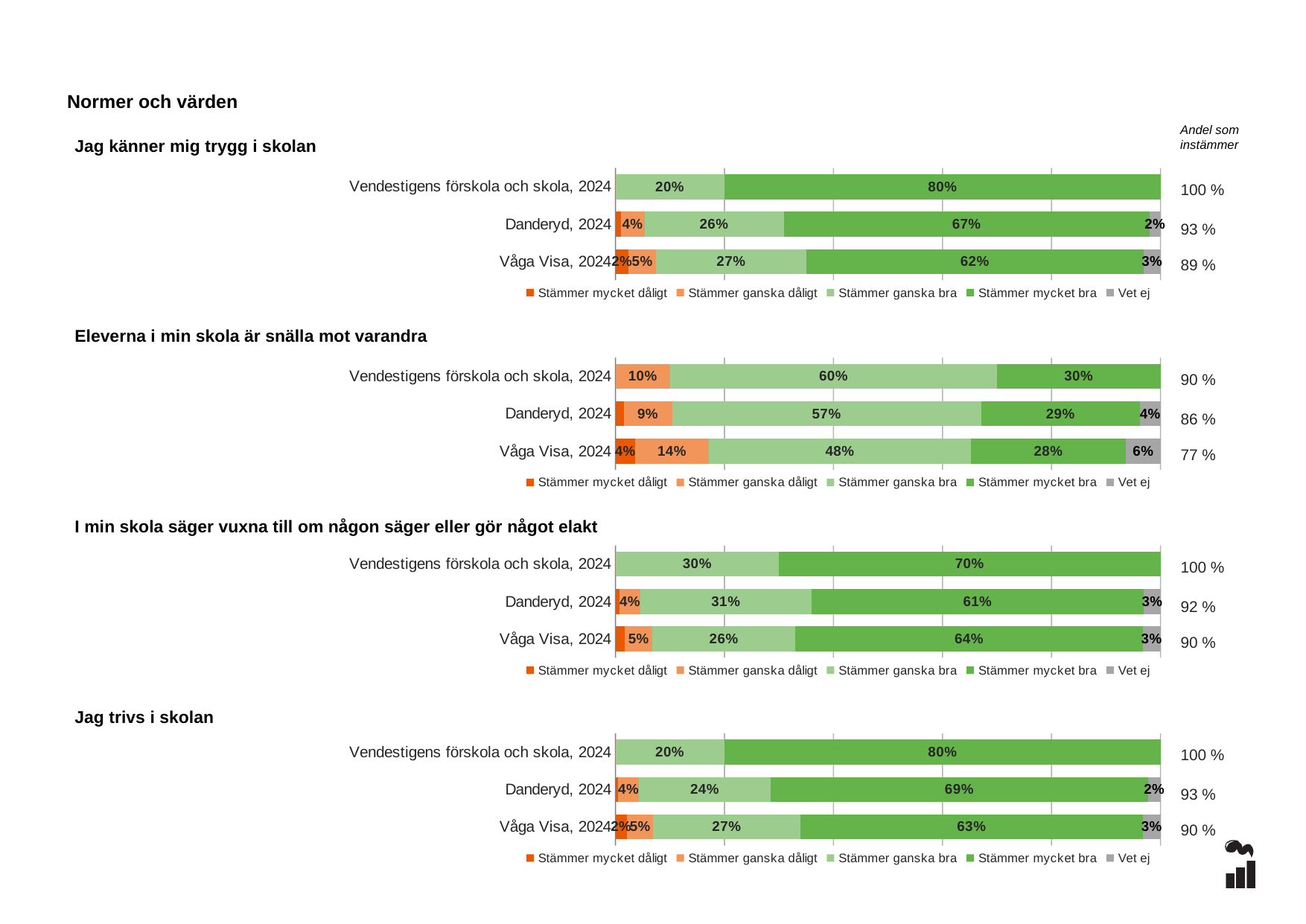
In the chart 'Eleverna i min skola är snälla mot varandra', what is the 'Stämmer ganska bra' value for Danderyd, 2024? 57% How many rows (categories) does the chart 'Jag trivs i skolan' show? 3 In the chart 'I min skola säger vuxna till om någon säger eller gör något elakt', which is larger: the 'Stämmer mycket bra' value for Danderyd, 2024 or for Våga Visa, 2024? Våga Visa, 2024 In the chart 'Jag trivs i skolan', what is the 'Andel som instämmer' value for Danderyd, 2024? 93 % In the chart 'Eleverna i min skola är snälla mot varandra', which row has the lowest 'Andel som instämmer'? Våga Visa, 2024 In the chart 'I min skola säger vuxna till om någon säger eller gör något elakt', what is the 'Stämmer mycket bra' value for Våga Visa, 2024? 64% How many series does the legend of the chart 'Jag känner mig trygg i skolan' list? 5 In the chart 'Jag känner mig trygg i skolan', which row has the highest 'Stämmer mycket bra' value? Vendestigens förskola och skola, 2024 In the chart 'Eleverna i min skola är snälla mot varandra', what is the difference between the 'Stämmer ganska bra' values for Vendestigens förskola och skola, 2024 and Våga Visa, 2024? 12% What kind of chart is used for 'Eleverna i min skola är snälla mot varandra'? Stacked bar chart In the chart 'Jag trivs i skolan', what is the 'Vet ej' value for Våga Visa, 2024? 3% In the chart 'Jag känner mig trygg i skolan', what percentage of Vendestigens förskola och skola, 2024 answered 'Stämmer mycket bra'? 80%